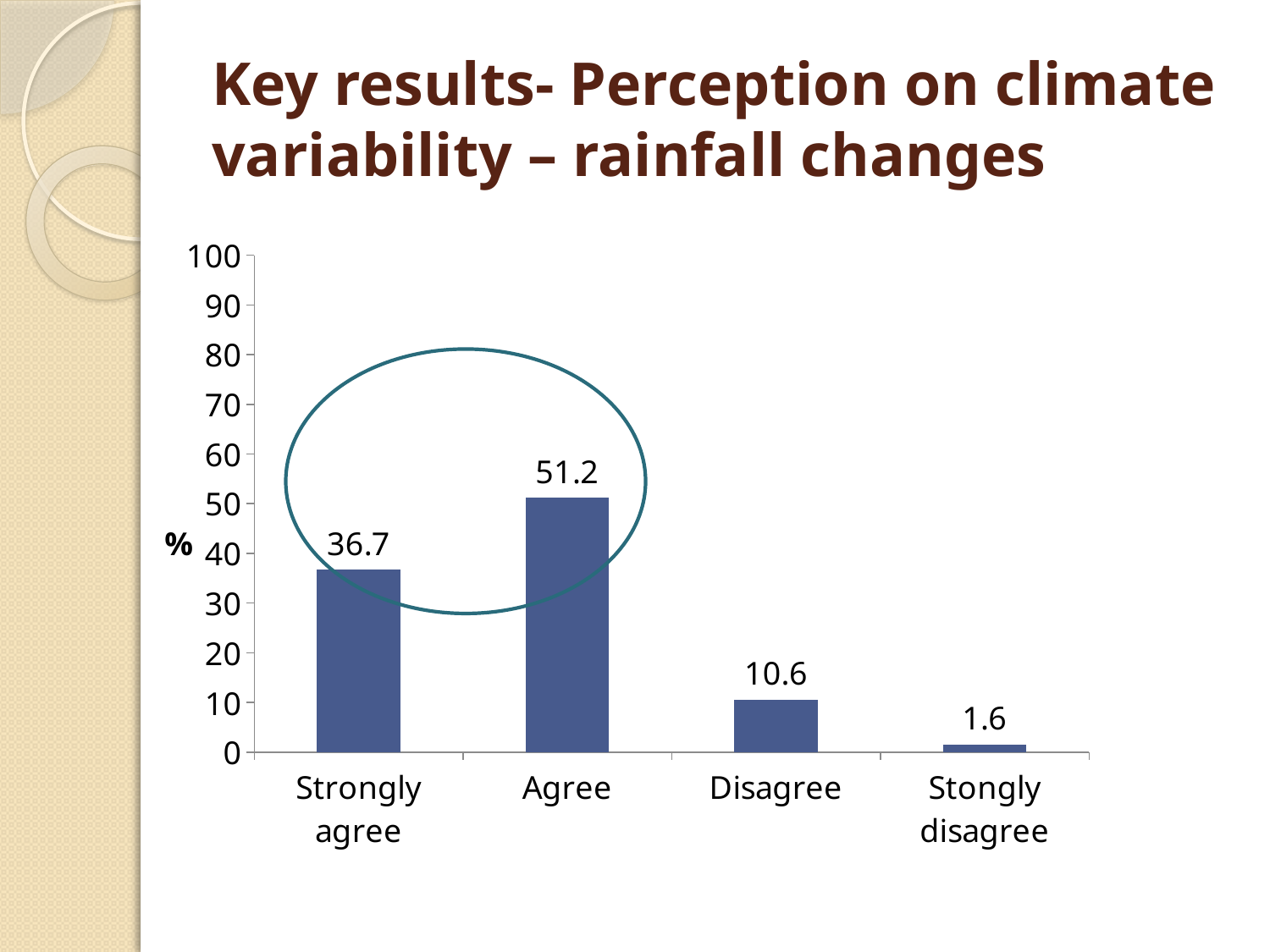
What is the value for Disagree? 10.6 Which category has the lowest value? Stongly disagree What is the value for Agree? 51.2 What is the label on the vertical axis? % How many categories are shown on the x axis? 4 What is the value for Stongly disagree? 1.6 Which category has the highest value? Agree Is the value for Disagree greater or less than 20? less What is the value for Strongly agree? 36.7 What is the difference between the values for Agree and Strongly agree? 14.5 Which is larger, the value for Strongly agree or the value for Disagree? Strongly agree What kind of chart is shown on the slide? bar chart